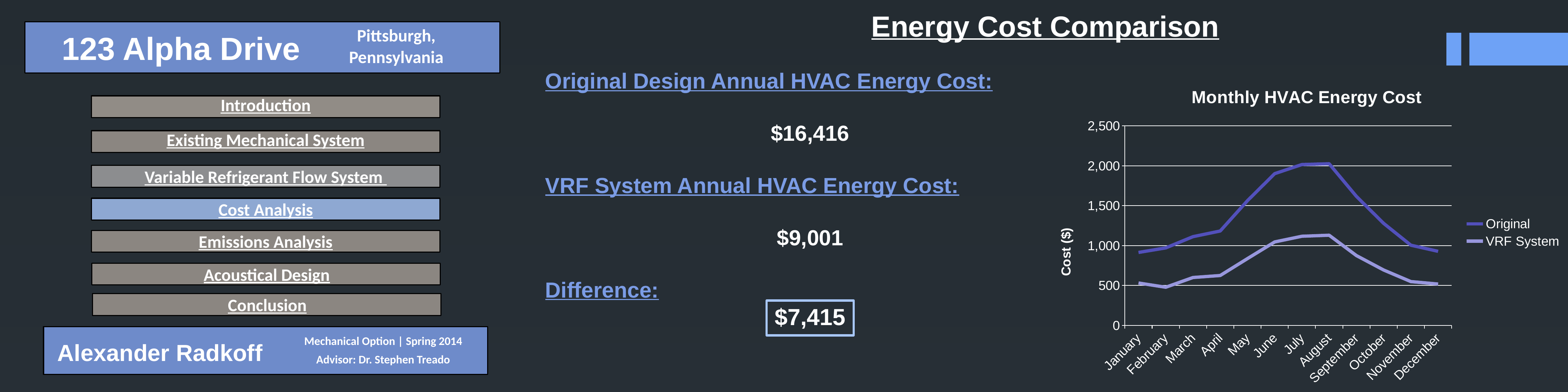
In the Monthly HVAC Energy Cost chart, does the VRF System series rise or fall from August to December? fall In the Monthly HVAC Energy Cost chart, is the Original value for January greater or less than 1,000? less How many months are plotted along the x axis of the Monthly HVAC Energy Cost chart? 12 What is the label on the y axis of the Monthly HVAC Energy Cost chart? Cost ($) In the Monthly HVAC Energy Cost chart, which series has the higher value in August, Original or VRF System? Original In the Monthly HVAC Energy Cost chart, is the Original value for July greater or less than 1,500? greater What kind of chart is the Monthly HVAC Energy Cost chart? line chart What is the title of the chart on the slide? Monthly HVAC Energy Cost In the Monthly HVAC Energy Cost chart, does the Original series rise or fall from January to July? rise How many series does the legend of the Monthly HVAC Energy Cost chart list? 2